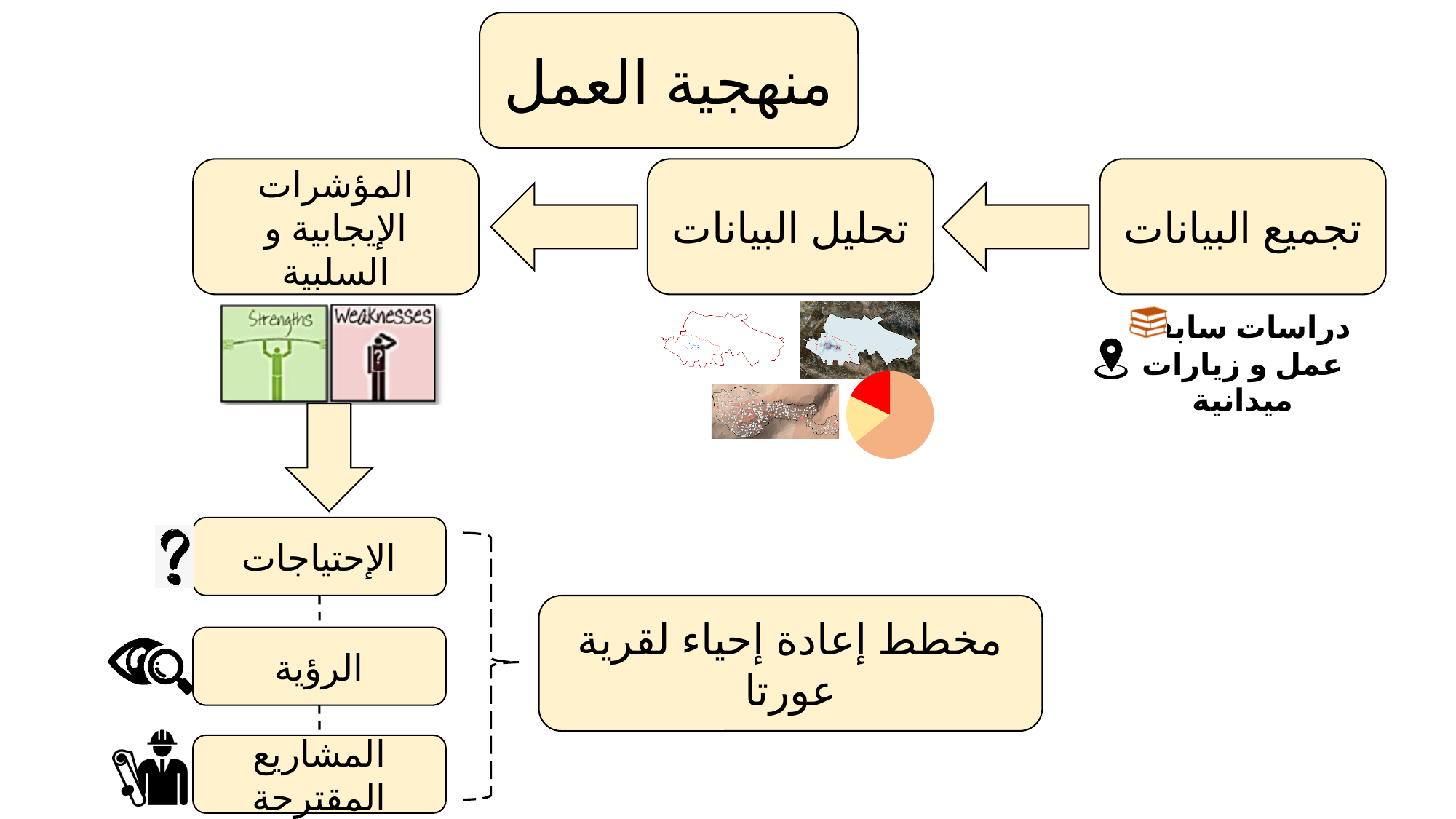
Does the pie chart on the slide show a legend? No Is the orange slice of the pie chart larger or smaller than the yellow slice? larger Is the orange slice of the pie chart larger or smaller than the red slice? larger What colours are used for the slices of the pie chart? red, yellow and orange What kind of chart is shown in the middle of the slide, below the data analysis box? pie chart Which colour slice of the pie chart is the largest? orange How many slices does the pie chart on the slide have? 3